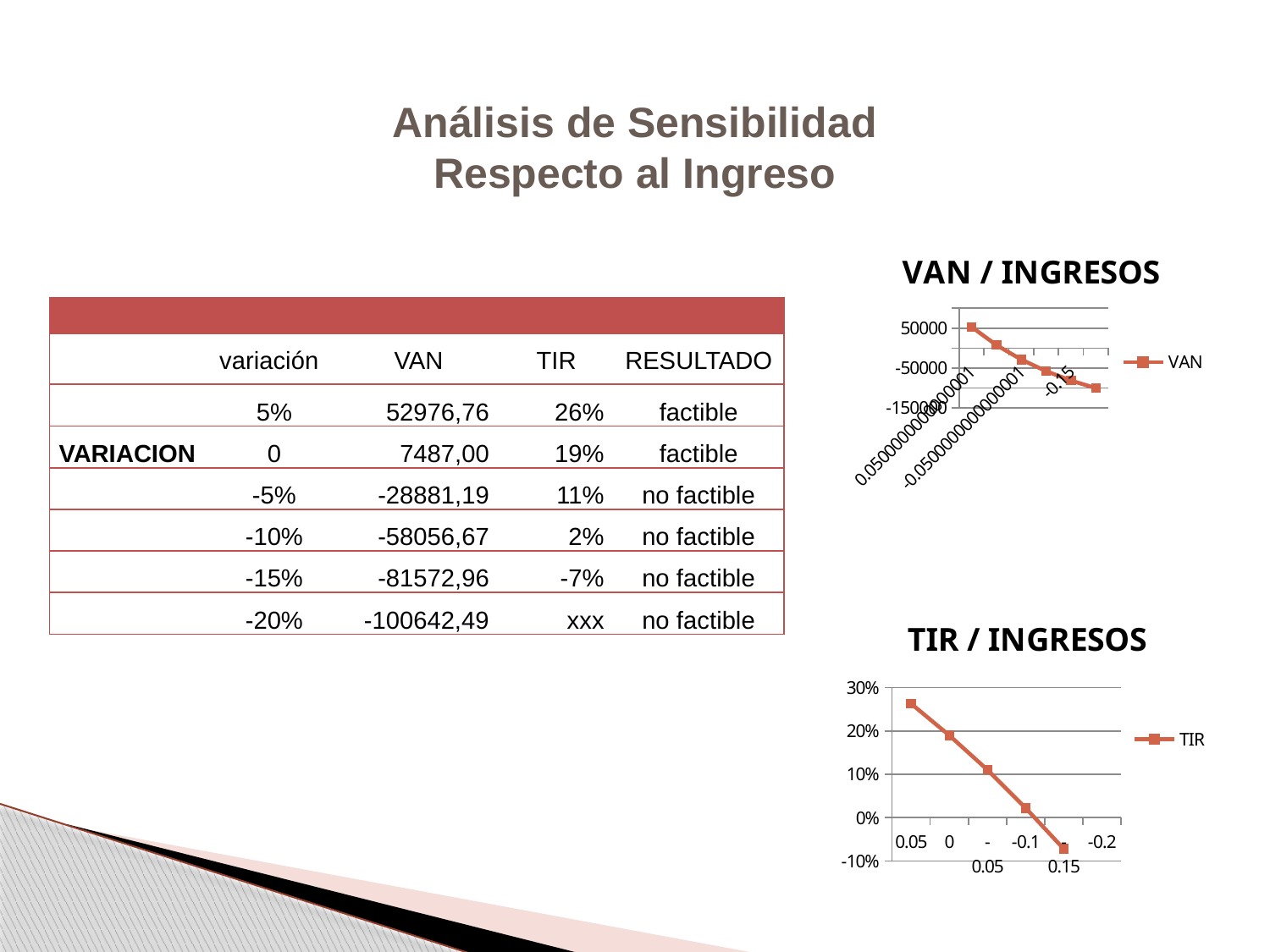
In the VAN / INGRESOS chart, how many data points are plotted on the line? 6 In the VAN / INGRESOS chart, what is the name of the series shown in the legend? VAN In the VAN / INGRESOS chart, is the value of the last (rightmost) point greater or less than -50000? less In the TIR / INGRESOS chart, do the values rise or fall from left to right along the x axis? fall In the TIR / INGRESOS chart, is the value at x = -0.1 greater or less than 10%? less In the TIR / INGRESOS chart, is the value at x = -0.15 greater or less than 0%? less In the TIR / INGRESOS chart, how many series does the legend list? 1 In the VAN / INGRESOS chart, do the values rise or fall from left to right along the x axis? fall What kind of chart is the VAN / INGRESOS chart? line chart In the TIR / INGRESOS chart, how many data points are plotted on the line? 5 What kind of chart is the TIR / INGRESOS chart? line chart